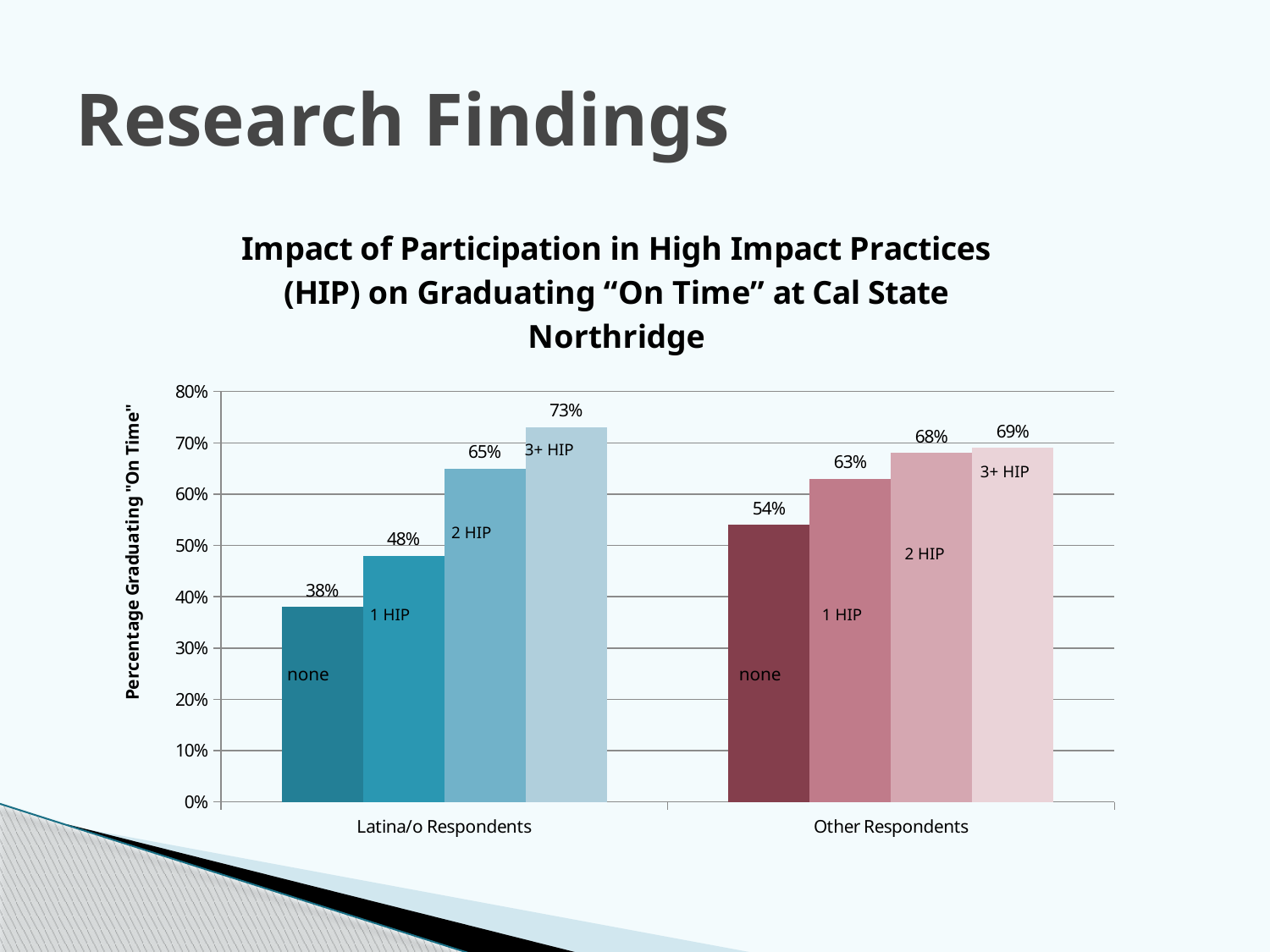
What is the value for Other Respondents with 1 HIP? 63% What kind of chart is shown on the slide? bar chart Which HIP level has the lowest on-time graduation rate among Other Respondents? none What is the value for Latina/o Respondents with 2 HIP? 65% Which is larger: the 3+ HIP value for Latina/o Respondents or the 3+ HIP value for Other Respondents? Latina/o Respondents What percentage of Latina/o respondents with no HIP participation graduated on time? 38% What is the value for Other Respondents with 3+ HIP? 69% What is the difference between the 3+ HIP and none values for Latina/o Respondents? 35% What is the label of the vertical axis? Percentage Graduating "On Time" Which HIP level has the highest on-time graduation rate among Latina/o Respondents? 3+ HIP What is the difference between the none values for Other Respondents and Latina/o Respondents? 16% Do the values rise or fall as HIP participation increases from none to 3+ HIP for Latina/o Respondents? rise